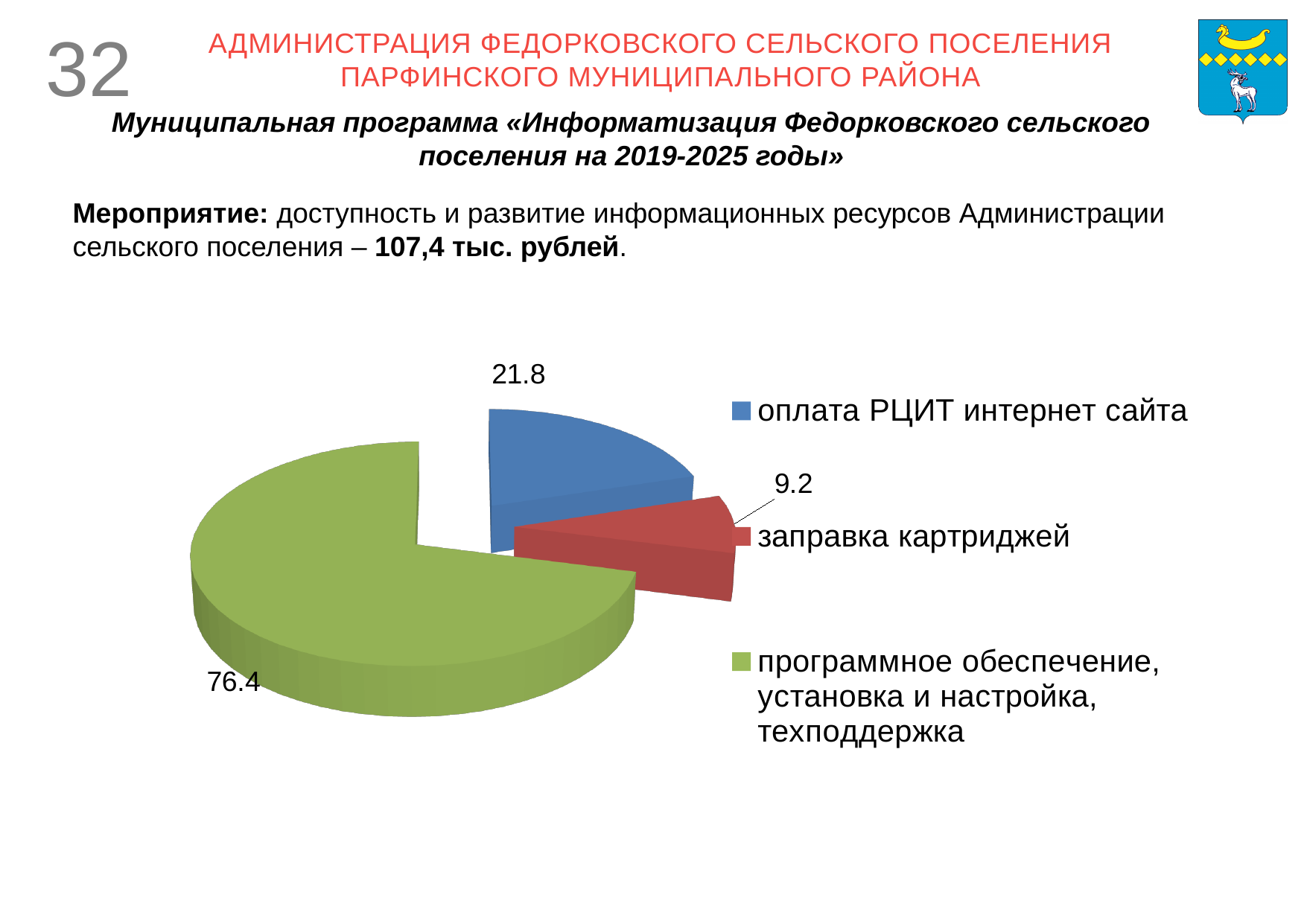
What is the total of all three slices in the pie chart? 107.4 What is the value for «заправка картриджей» in the pie chart? 9.2 What kind of chart is shown on the slide? pie chart What is the value for «программное обеспечение, установка и настройка, техподдержка» in the pie chart? 76.4 Which category has the largest slice in the pie chart? программное обеспечение, установка и настройка, техподдержка What colour is the slice for «заправка картриджей» in the pie chart? red How many entries does the legend of the pie chart list? 3 How many slices does the pie chart have? 3 Which is larger: the value for «оплата РЦИТ интернет сайта» or for «заправка картриджей»? оплата РЦИТ интернет сайта What is the difference between the values for «программное обеспечение, установка и настройка, техподдержка» and «оплата РЦИТ интернет сайта»? 54.6 Which category has the smallest slice in the pie chart? заправка картриджей What is the value for «оплата РЦИТ интернет сайта» in the pie chart? 21.8